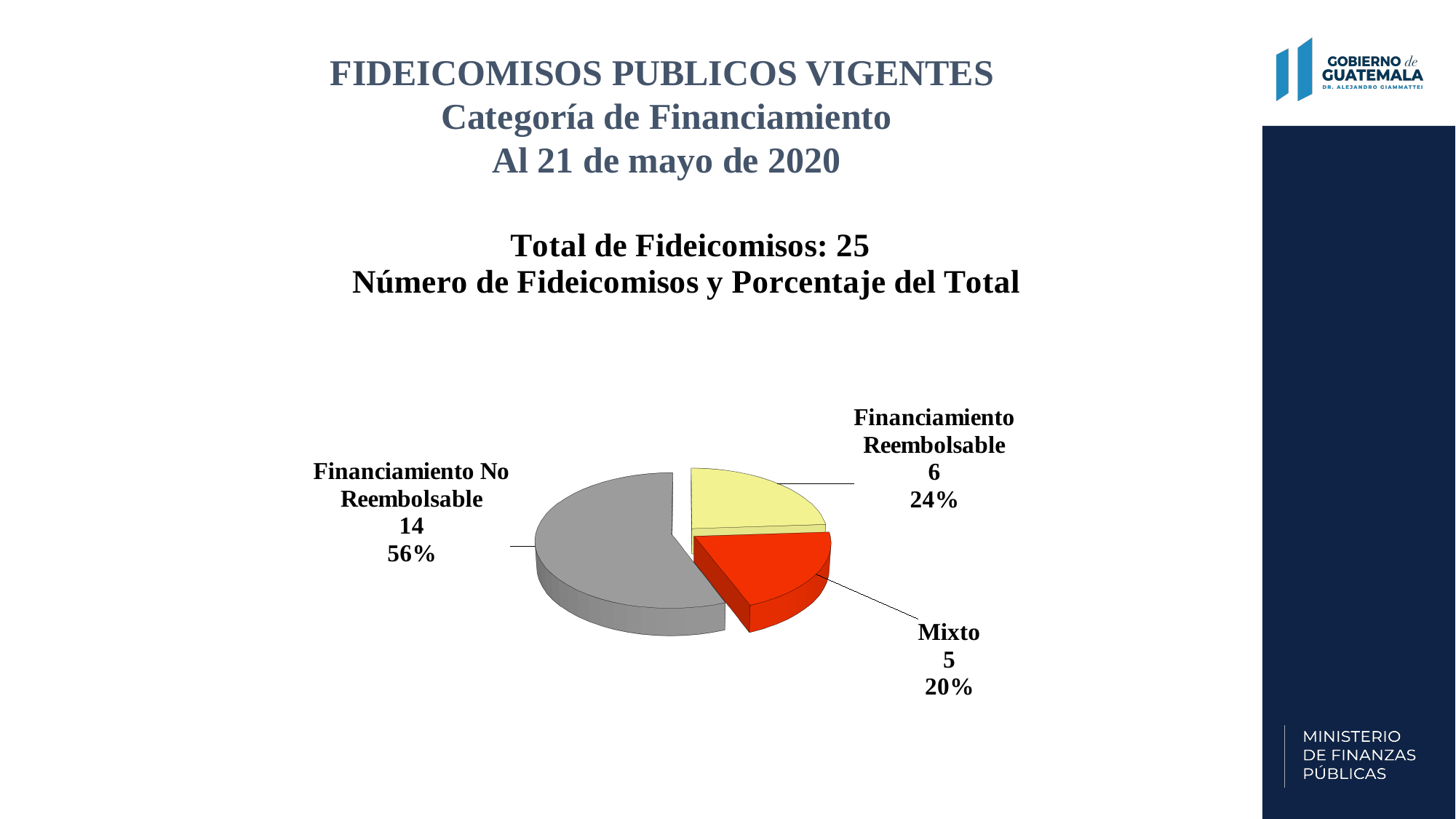
What percentage of the total does the Mixto slice represent? 20% What percentage of the total does the Financiamiento Reembolsable slice represent? 24% What colour is the Mixto slice of the pie? Red Which category has the smallest share of the pie? Mixto How many categories are shown in the pie chart? 3 Which has more fideicomisos, Financiamiento Reembolsable or Mixto? Financiamiento Reembolsable How many fideicomisos are in the Financiamiento No Reembolsable category? 14 Which category has the largest share of the pie? Financiamiento No Reembolsable What kind of chart is shown on the slide? Pie chart How many fideicomisos are in the Financiamiento Reembolsable category? 6 How many fideicomisos are in the Mixto category? 5 What is the difference in the number of fideicomisos between Financiamiento No Reembolsable and Financiamiento Reembolsable? 8